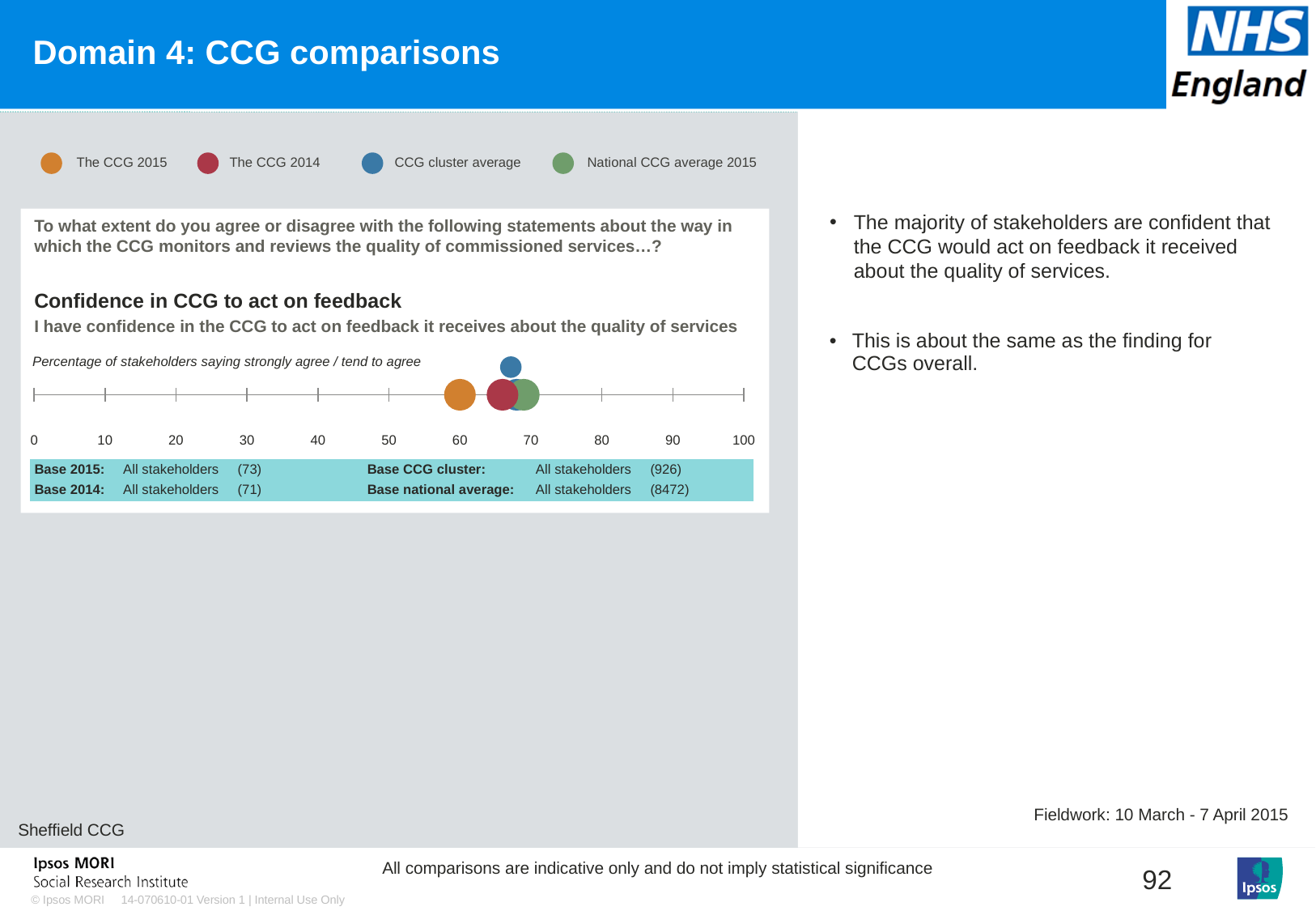
Is the value for The CCG 2015 greater or less than 50? greater Is the value for the CCG cluster average greater or less than 70? less What colour is used for The CCG 2015 in the legend? Orange How many data points are plotted on the axis? 4 Is the value for The CCG 2014 greater or less than 60? greater Which series has the lowest value on the chart? The CCG 2015 What kind of chart is shown on the slide? Dot plot How many series does the legend list? 4 Which is larger, the value for The CCG 2015 or the National CCG average 2015? National CCG average 2015 What is the maximum value shown on the chart's axis? 100